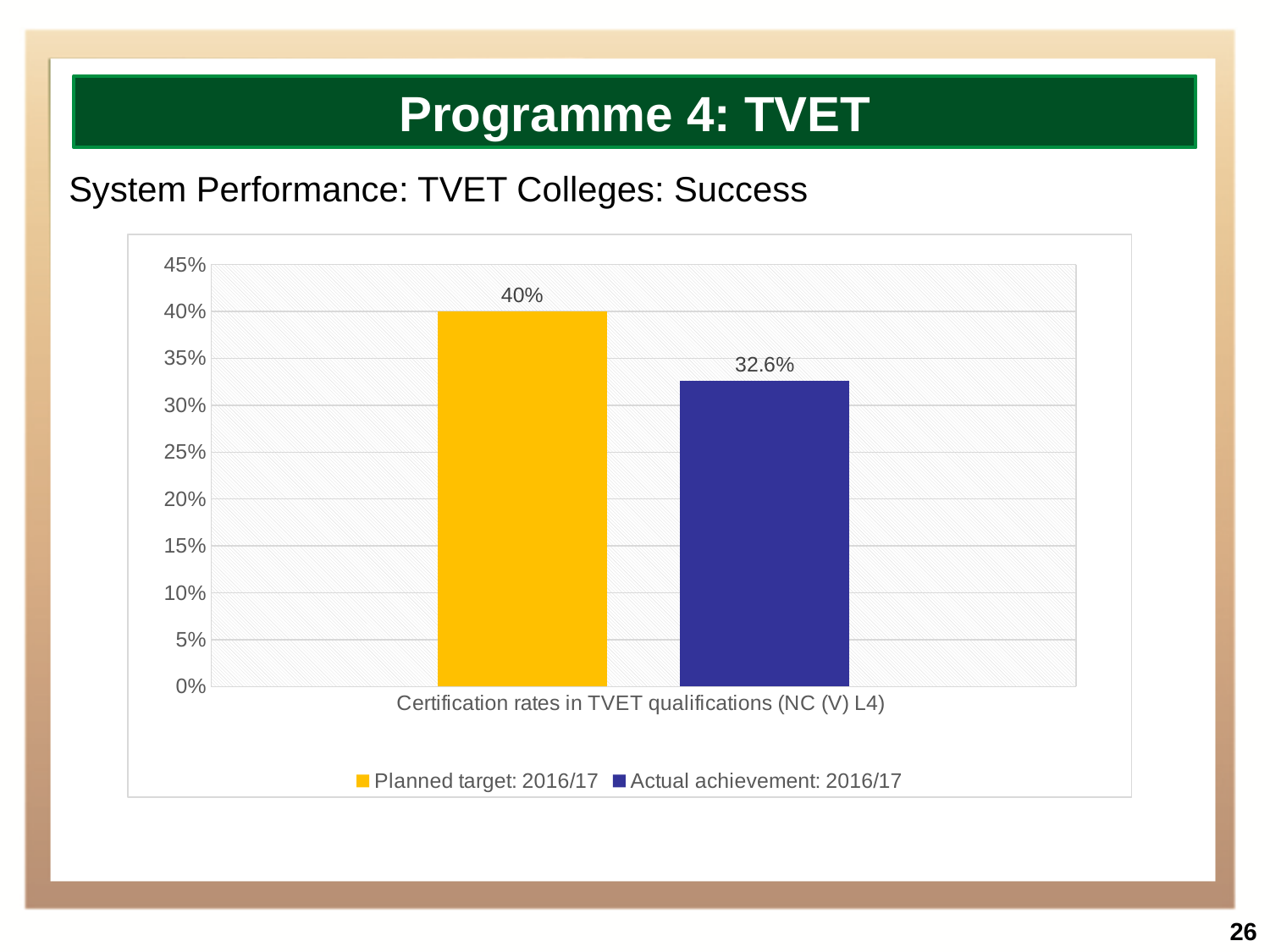
What is the actual achievement for 2016/17 for certification rates in TVET qualifications (NC (V) L4)? 32.6% What is the planned target for 2016/17 for certification rates in TVET qualifications (NC (V) L4)? 40% Is the planned target for 2016/17 greater or less than 35%? greater What is the category label on the x axis? Certification rates in TVET qualifications (NC (V) L4) What kind of chart is shown on the slide? Bar chart How many series does the legend list? 2 Which series has the higher value: Planned target: 2016/17 or Actual achievement: 2016/17? Planned target: 2016/17 Is the actual achievement for 2016/17 greater or less than 35%? less How many categories are shown on the x axis? 1 By how many percentage points does the planned target exceed the actual achievement for 2016/17? 7.4 percentage points What is the maximum value shown on the y axis? 45% Which colour represents Actual achievement: 2016/17 in the chart? Blue